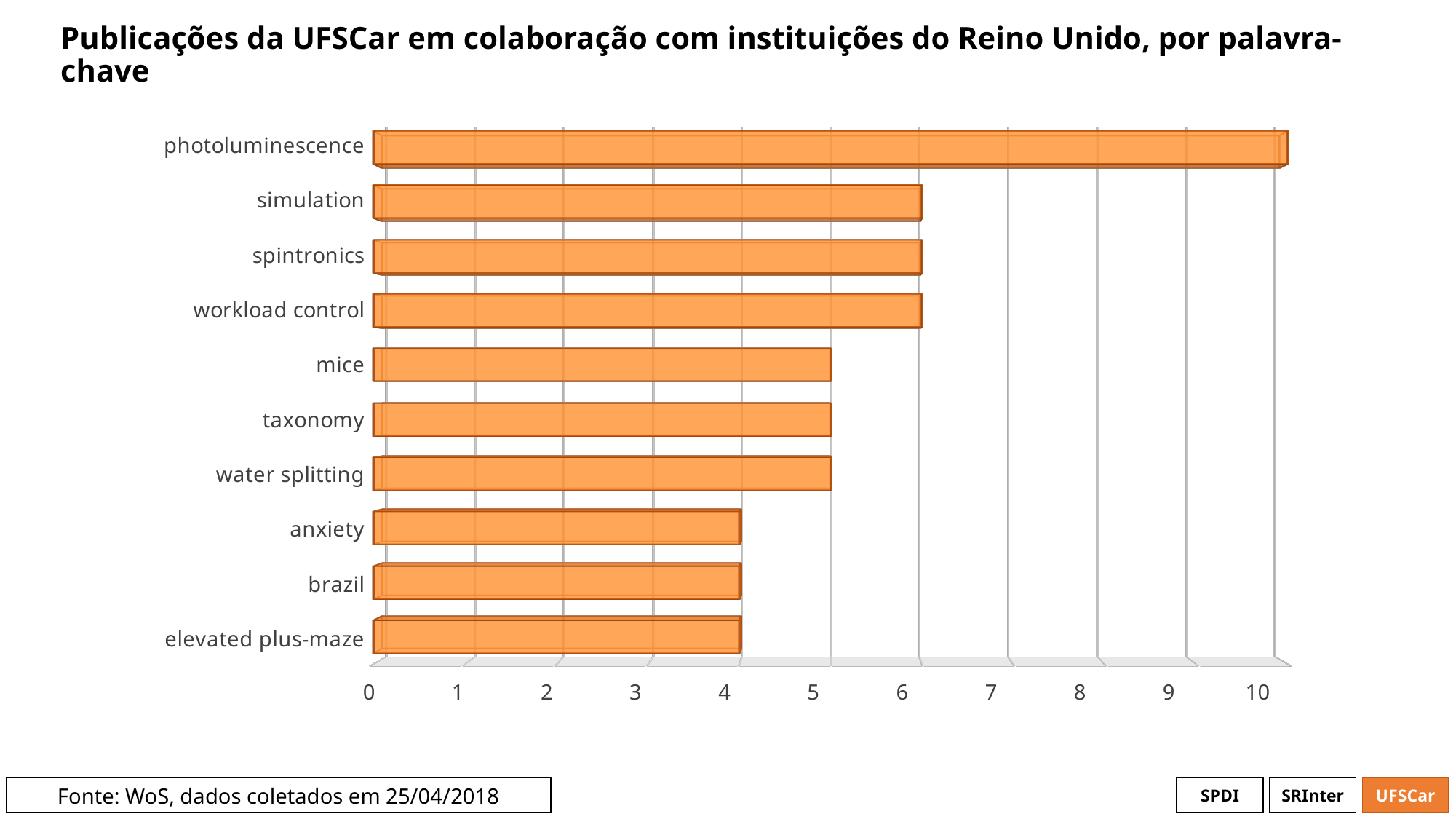
Is the value for anxiety greater or less than 5? less Which is larger, the value for workload control or the value for taxonomy? workload control What kind of chart is shown on the slide? bar chart What is the value for photoluminescence? 10 What is the value for mice? 5 How many keywords (categories) are shown in the chart? 10 What is the data source cited at the bottom of the slide? WoS, dados coletados em 25/04/2018 What is the value for brazil? 4 What is the value for simulation? 6 Which keyword has the highest number of publications? photoluminescence Is the value for water splitting greater or less than 4? greater What is the difference between the values for photoluminescence and spintronics? 4